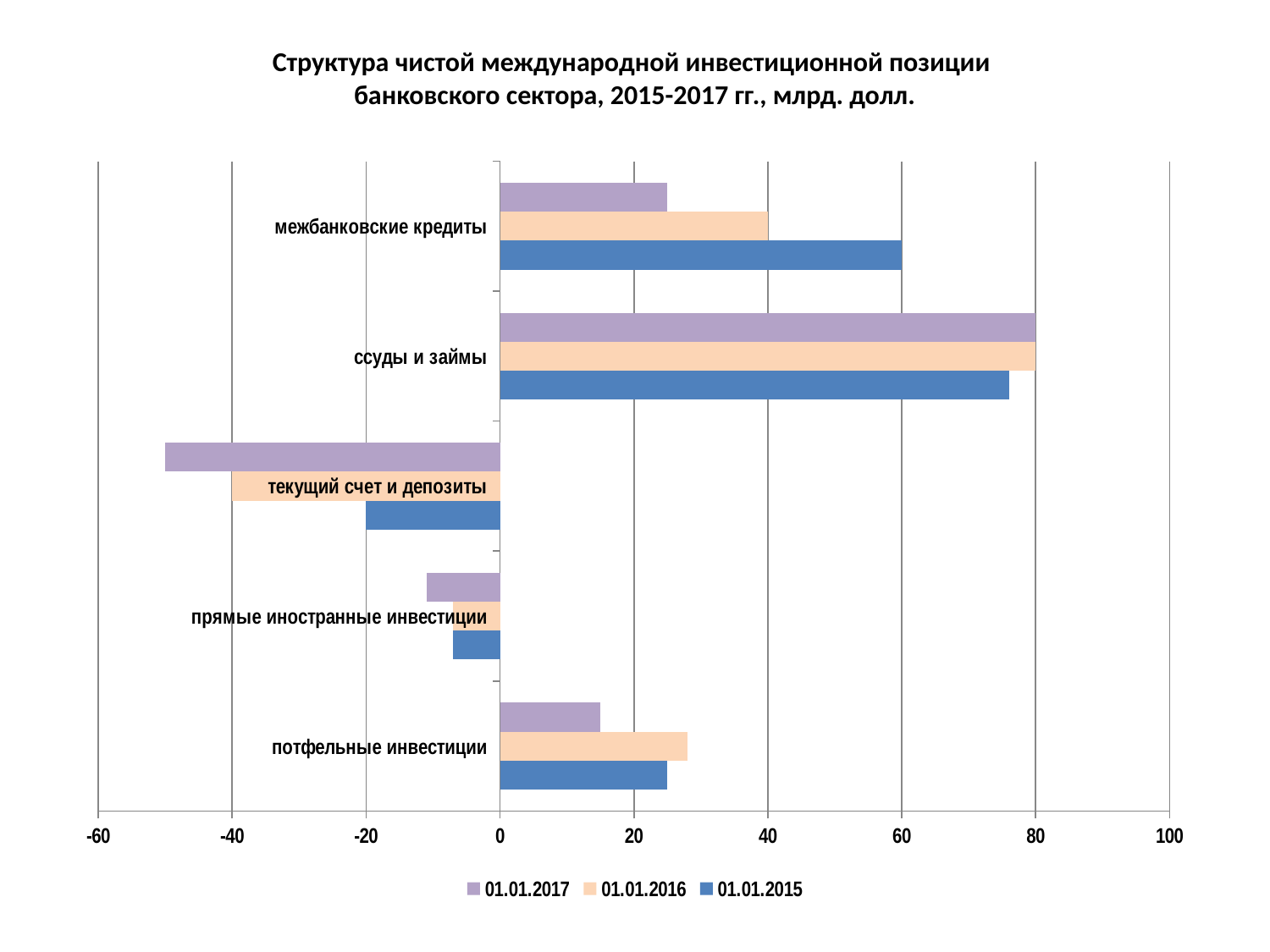
Which is larger for потфельные инвестиции: the 01.01.2016 value or the 01.01.2017 value? 01.01.2016 Which series is shown in dark blue in the legend? 01.01.2015 What is the value for ссуды и займы for 01.01.2017? 80 How many series does the legend list? 3 Which category has the lowest value for 01.01.2017? текущий счет и депозиты What kind of chart is shown on the slide? bar chart How many categories are shown on the chart? 5 Is the value for текущий счет и депозиты for 01.01.2017 greater or less than -40? less What is the value for текущий счет и депозиты for 01.01.2015? -20 What is the value for межбанковские кредиты for 01.01.2016? 40 What is the value for межбанковские кредиты for 01.01.2015? 60 What is the difference between the 01.01.2015 and 01.01.2016 values for межбанковские кредиты? 20